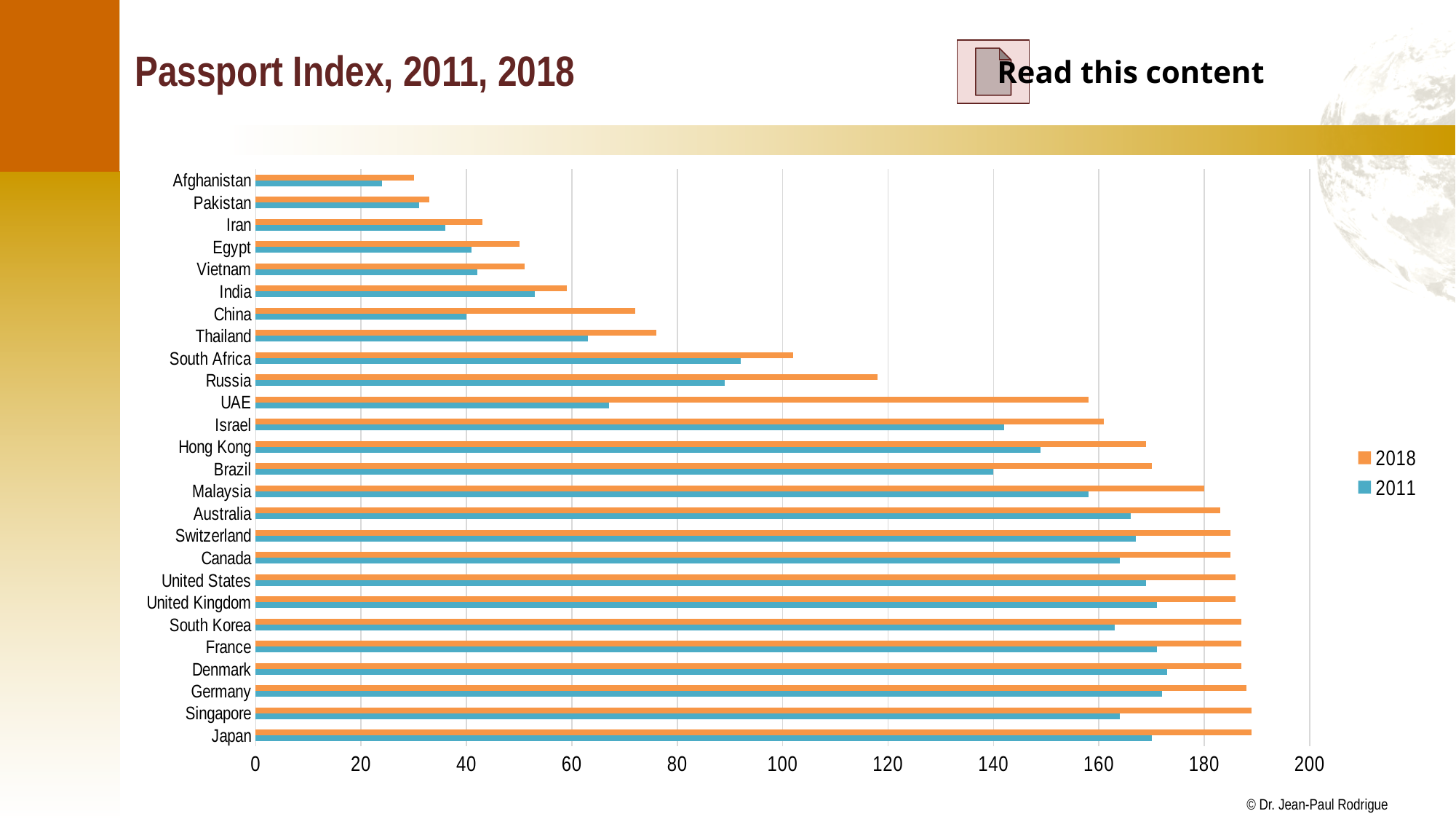
Which has the larger 2018 value, Russia or South Africa? Russia Do the 2018 values generally increase or decrease going down the list from Afghanistan to Japan? increase Is the 2011 value for Japan greater or less than 160? greater Is the 2011 value for Russia greater or less than 100? less How many countries are listed on the chart? 26 How many series does the legend list? 2 Is the 2018 value for China greater or less than 60? greater What kind of chart is shown on the slide? bar chart Which two years are shown in the legend? 2018 and 2011 For UAE, which year has the larger value, 2018 or 2011? 2018 Which country has the lowest 2011 value? Afghanistan